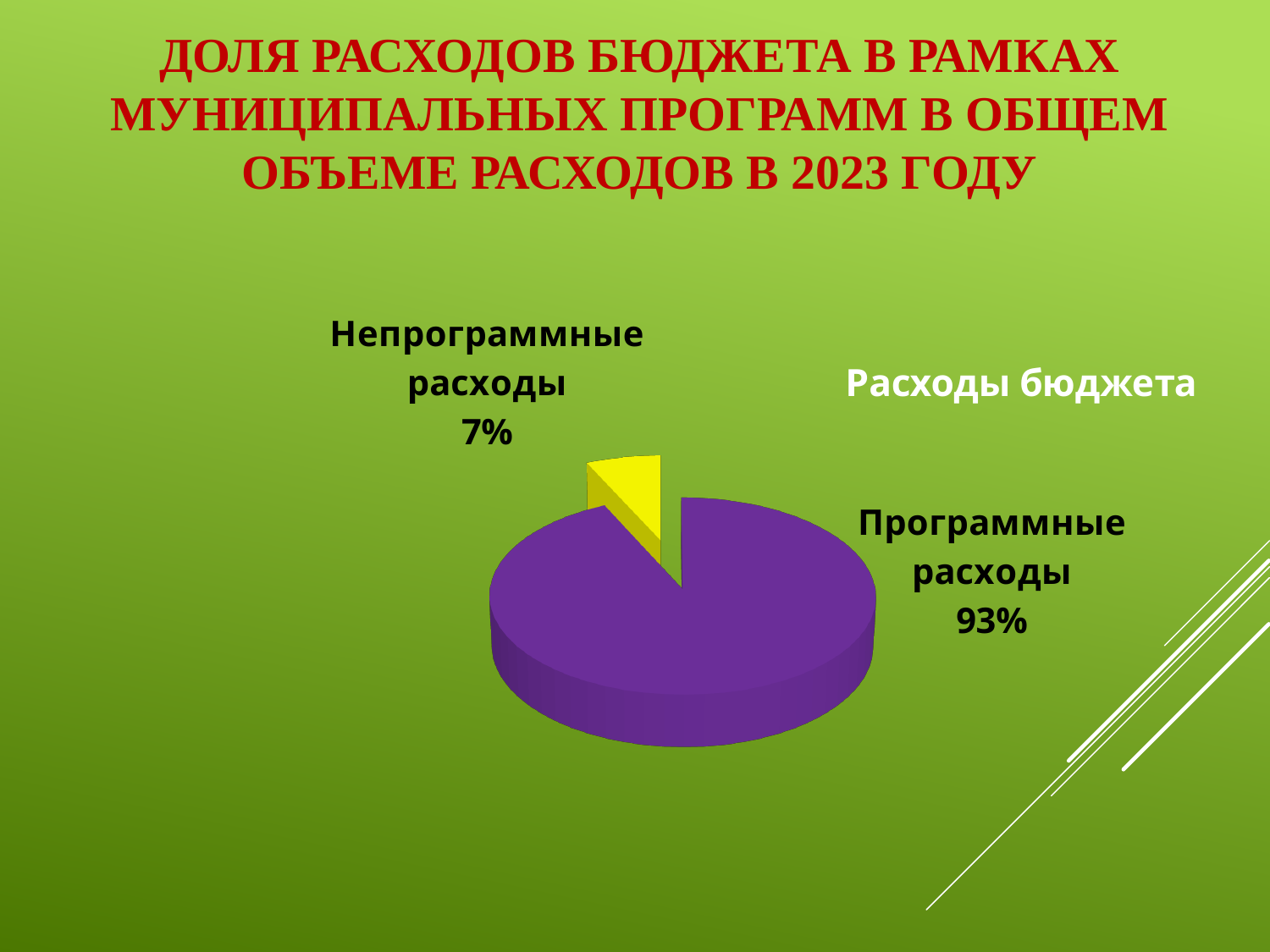
What kind of chart is shown on the slide? Pie chart What is the difference in percentage points between Программные расходы and Непрограммные расходы? 86 Which slice of the pie is the largest? Программные расходы What colour is the slice for Непрограммные расходы? Yellow How many slices does the pie chart have? 2 What share of the pie is labelled Непрограммные расходы? 7% Which slice of the pie is the smallest? Непрограммные расходы What is the title of the chart? Расходы бюджета What share of the pie is labelled Программные расходы? 93% Which is larger, Программные расходы or Непрограммные расходы? Программные расходы